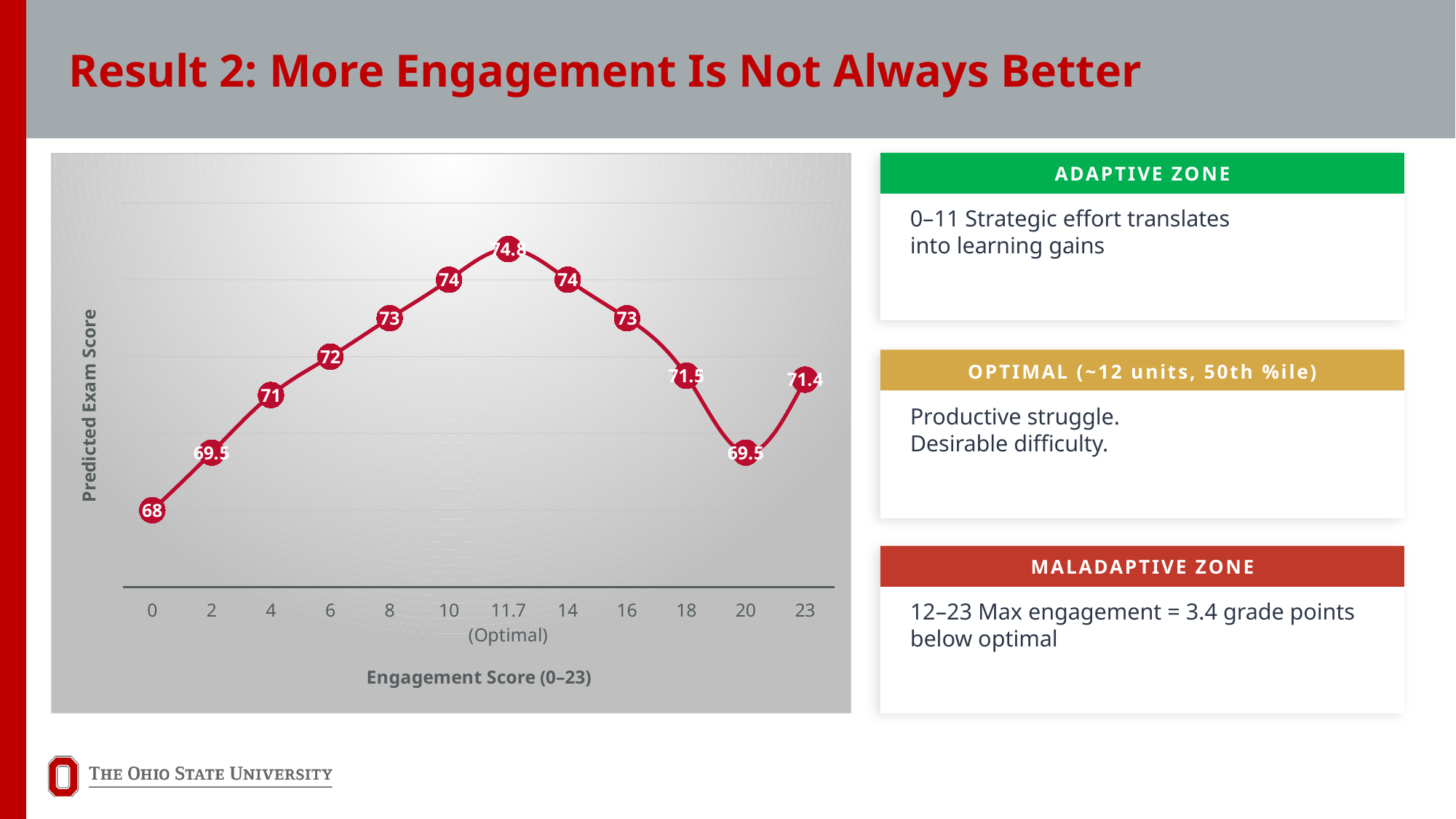
What is the predicted exam score at an engagement score of 18? 71.5 At which engagement score is the predicted exam score lowest? 0 What is the difference between the predicted exam score at engagement 11.7 and at engagement 23? 3.4 What is the predicted exam score at an engagement score of 11.7 (Optimal)? 74.8 What is the label of the x axis? Engagement Score (0–23) What type of chart is shown on the slide? line chart Does the predicted exam score rise or fall as the engagement score increases from 0 to 11.7? rise What is the predicted exam score at an engagement score of 0? 68 How many data points are plotted on the line? 12 At which engagement score is the predicted exam score highest? 11.7 (Optimal) What is the predicted exam score at an engagement score of 23? 71.4 Which has a higher predicted exam score: engagement score 8 or engagement score 20? engagement score 8